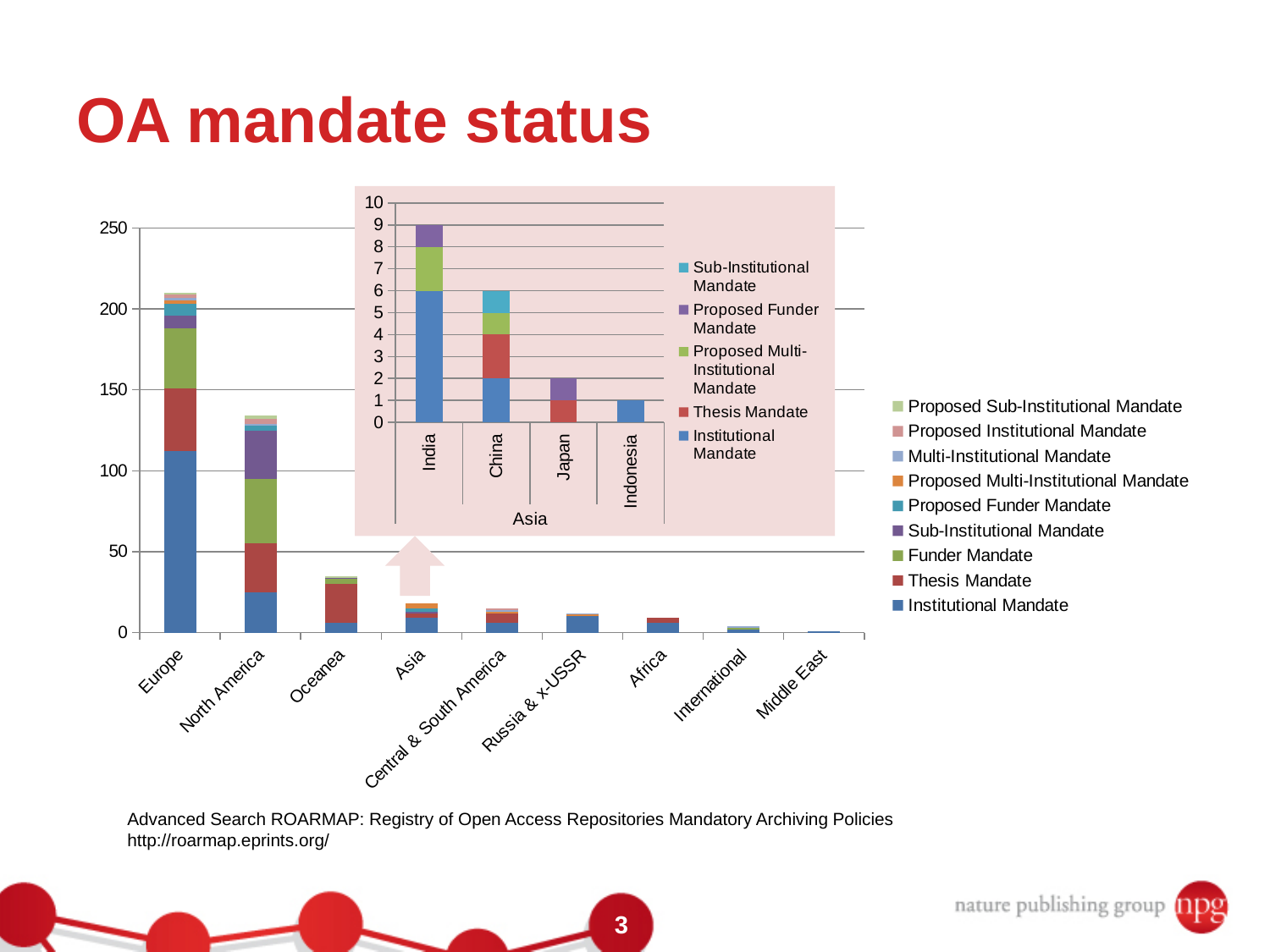
In the main chart by region, is the total for North America greater or less than 150? less In the inset Asia chart, how many series does the legend list? 5 In the main chart by region, how many regions are shown on the x axis? 9 In the main chart by region, is the total for Europe greater or less than 200? greater In the main chart by region, how many series does the legend list? 9 In the main chart by region, which has the larger total, Oceanea or Asia? Oceanea In the main chart by region, which region has the highest total? Europe In the inset Asia chart, what is the Institutional Mandate value for India? 6 In the inset Asia chart, how many countries are shown? 4 What kind of chart is the main chart showing mandates by region? Stacked bar chart In the inset Asia chart, what is the total height of the India bar? 9 In the inset Asia chart, which country has the highest total? India